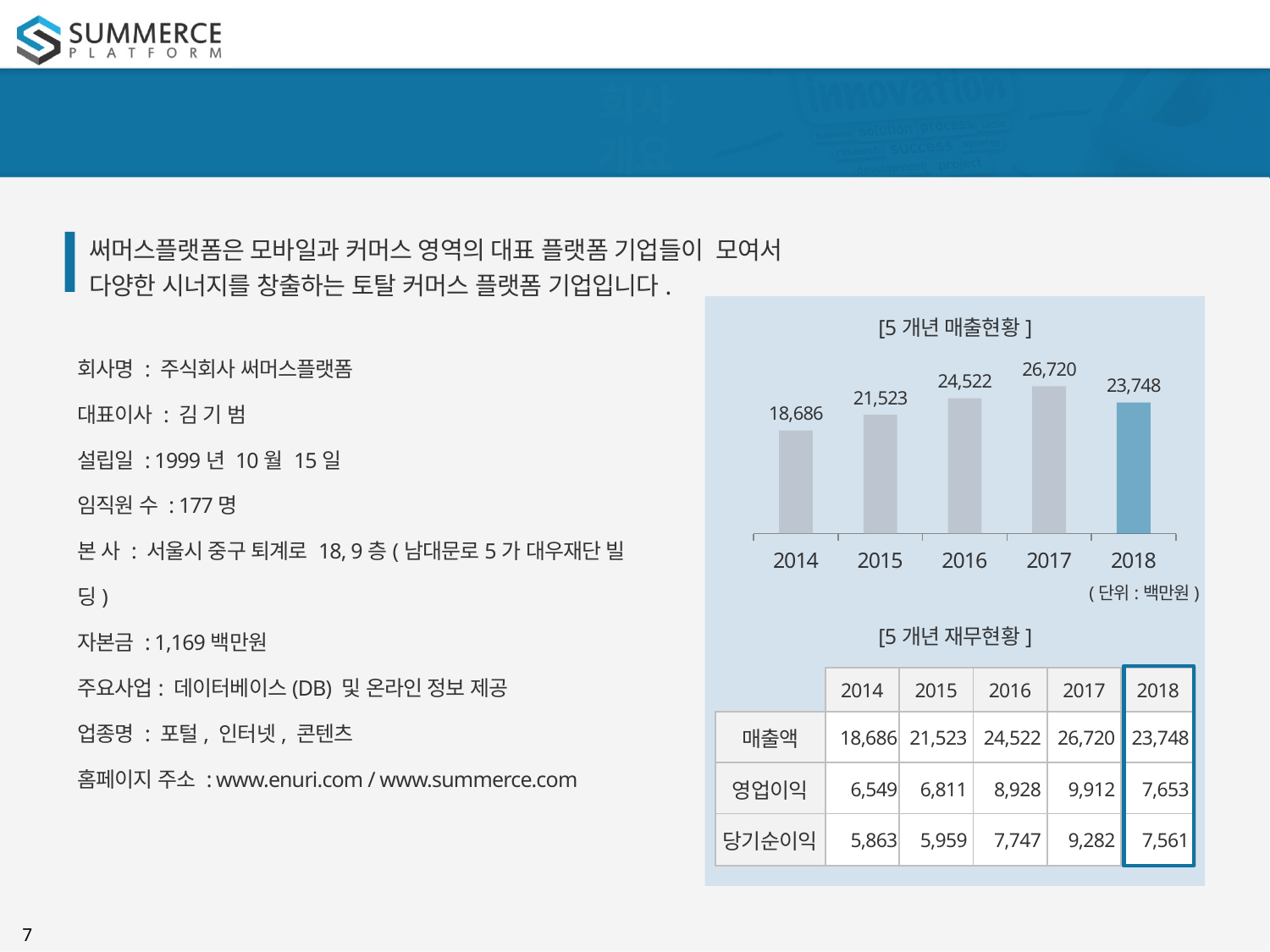
What kind of chart is the [5 개년 매출현황] chart? bar chart What unit is stated below the [5 개년 매출현황] chart? 백만원 Which year has the highest value in the [5 개년 매출현황] chart? 2017 What is the value for 2016 in the [5 개년 매출현황] chart? 24,522 What is the value for 2018 in the [5 개년 매출현황] chart? 23,748 What is the difference between the 2015 and 2014 values in the [5 개년 매출현황] chart? 2,837 What is the difference between the 2017 and 2018 values in the [5 개년 매출현황] chart? 2,972 In the [5 개년 매출현황] chart, which is larger, the value for 2016 or the value for 2018? 2016 In the [5 개년 매출현황] chart, do the values rise or fall from 2014 to 2017? rise Which year has the lowest value in the [5 개년 매출현황] chart? 2014 How many years are shown in the [5 개년 매출현황] chart? 5 What is the value for 2014 in the [5 개년 매출현황] chart? 18,686